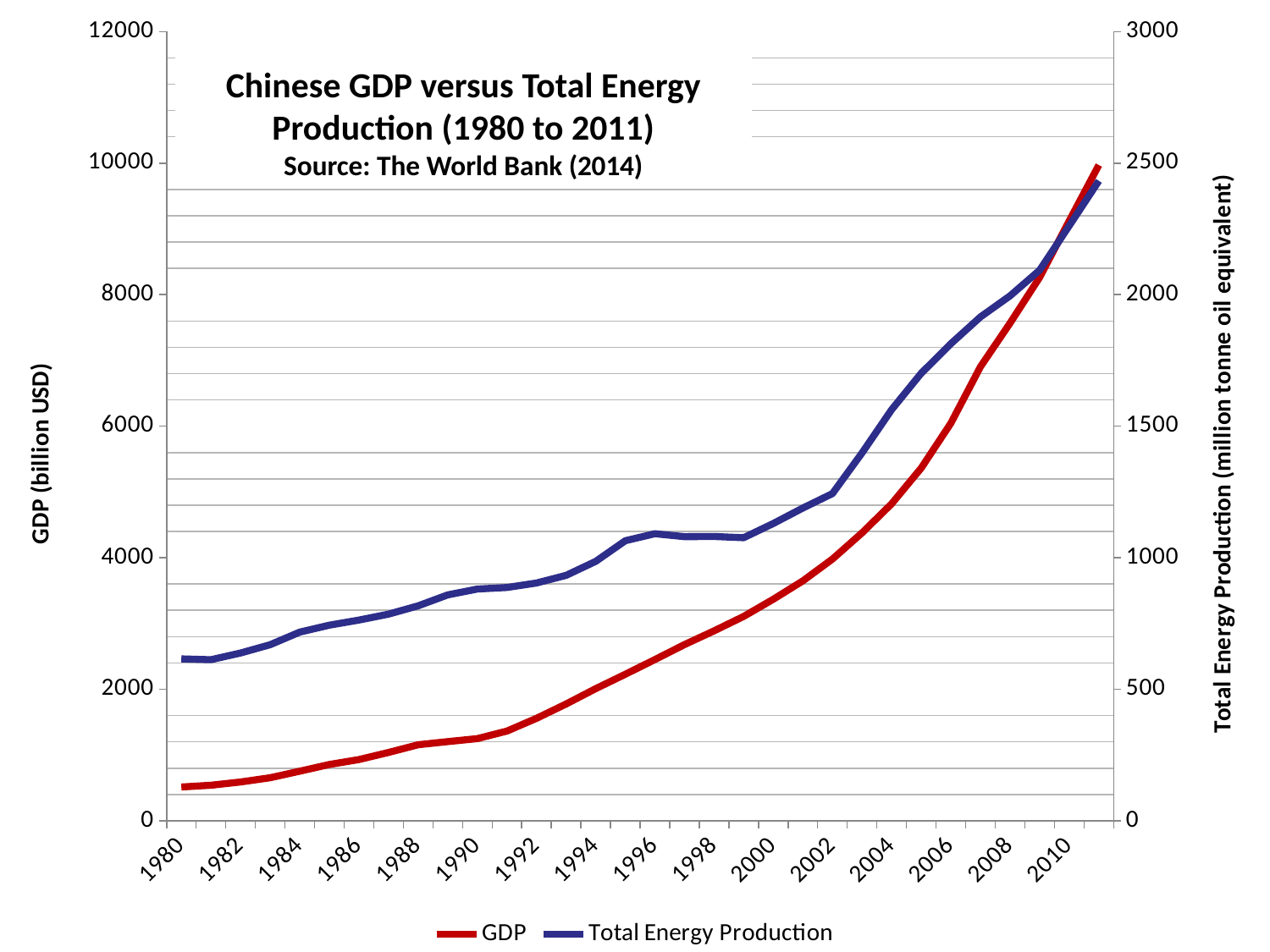
Is the GDP value for 2010 greater or less than 8000 billion USD? greater How many series does the legend list? 2 Is the Total Energy Production value for 1980 greater or less than 500 million tonne oil equivalent? greater What kind of chart is shown on the slide? Line chart Is the GDP value for 1980 greater or less than 2000 billion USD? less How many year labels are shown on the x axis? 16 What is the title of the chart? Chinese GDP versus Total Energy Production (1980 to 2011) Does GDP rise or fall from 1980 to 2011? Rise What is the label of the right-hand vertical axis? Total Energy Production (million tonne oil equivalent)